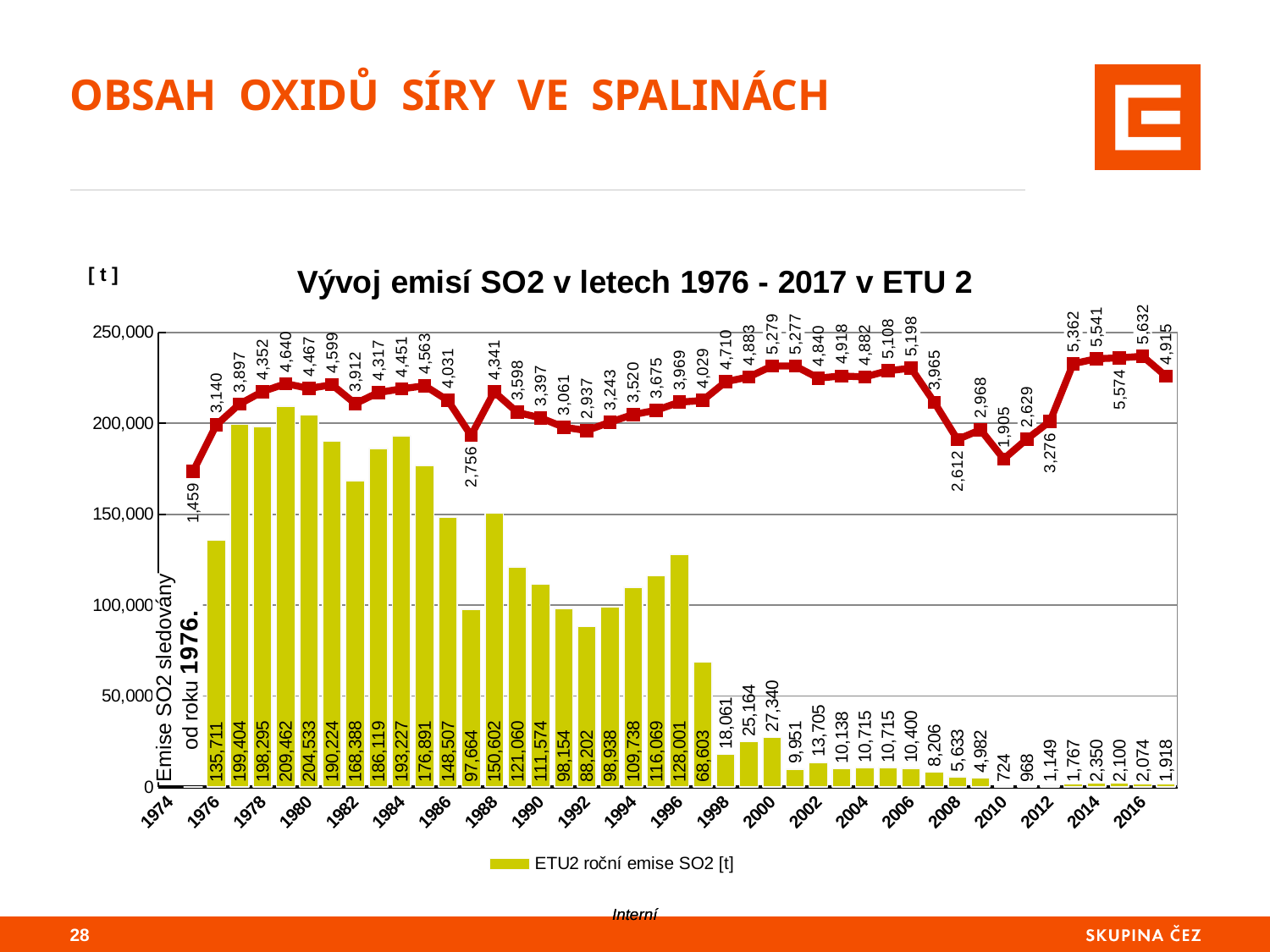
What type of chart is used to show the ETU2 roční emise SO2 [t] series? bar chart Overall, do the ETU2 roční emise SO2 [t] bars rise or fall from 1976 to 2017? fall Which year has the highest ETU2 roční emise SO2 [t] bar? 1979 Is the ETU2 roční emise SO2 [t] value for 1997 greater or less than 100,000? less What is the title of the chart? Vývoj emisí SO2 v letech 1976 - 2017 v ETU 2 Which year has the lowest ETU2 roční emise SO2 [t] bar? 2010 Which year has a larger ETU2 roční emise SO2 [t] value, 1994 or 1995? 1995 What is the difference between the ETU2 roční emise SO2 [t] values for 1977 and 1976? 63,693 What is the value of ETU2 roční emise SO2 [t] for 1976? 135,711 What is the value of ETU2 roční emise SO2 [t] for 1997? 68,603 What is the value of ETU2 roční emise SO2 [t] for 2017? 1,918 How many series does the legend list? 1